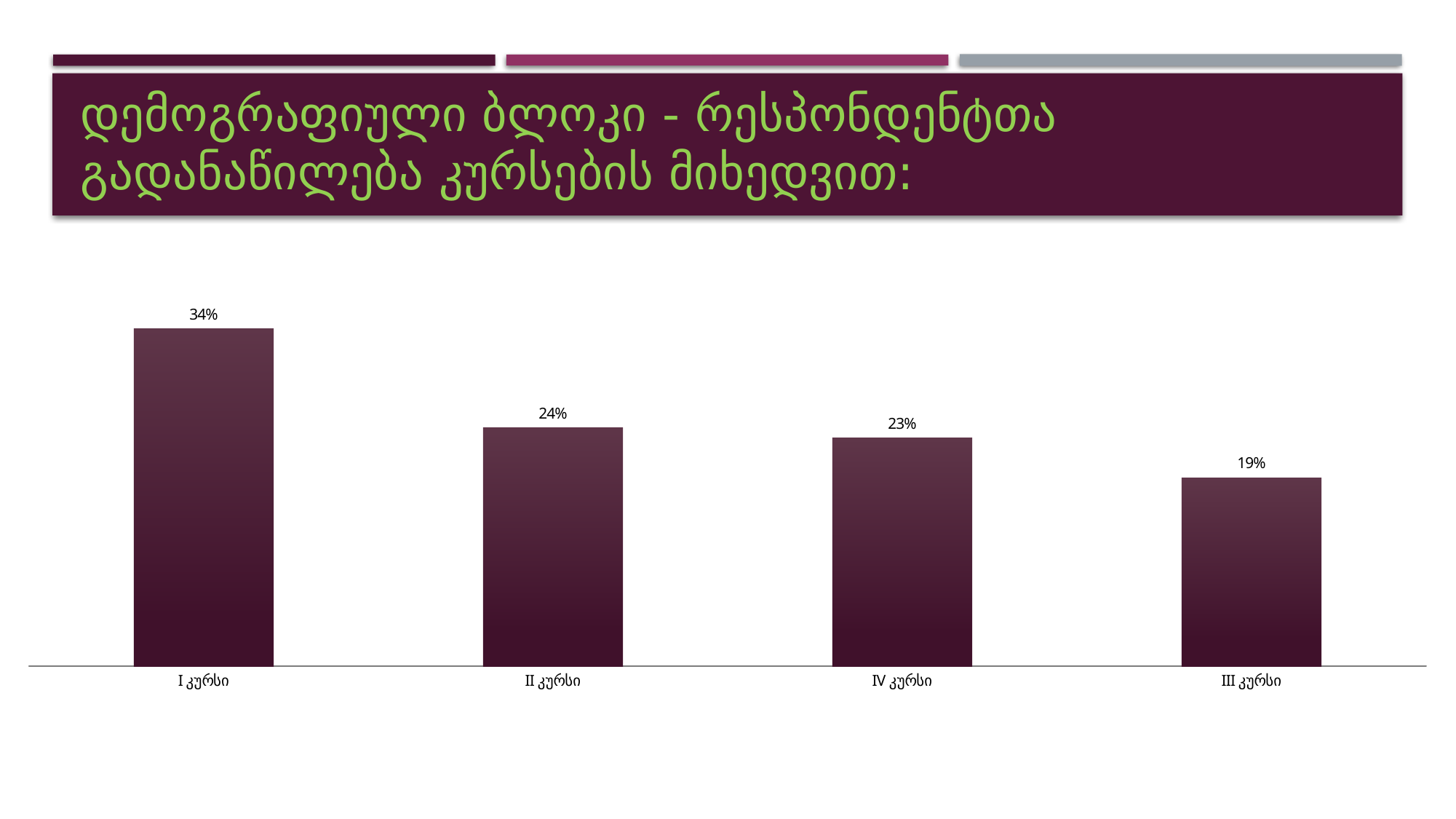
Do the values rise or fall from left to right along the x axis? fall Which category has the lowest value? III კურსი Which is larger, the value for I კურსი or the value for II კურსი? I კურსი How many categories are shown on the x axis? 4 What is the difference between the values for II კურსი and IV კურსი? 1% What is the value for III კურსი? 19% What kind of chart is shown on the slide? bar chart What is the value for IV კურსი? 23% What is the difference between the values for I კურსი and III კურსი? 15% What is the value for I კურსი? 34% Which category has the highest value? I კურსი What is the value for II კურსი? 24%